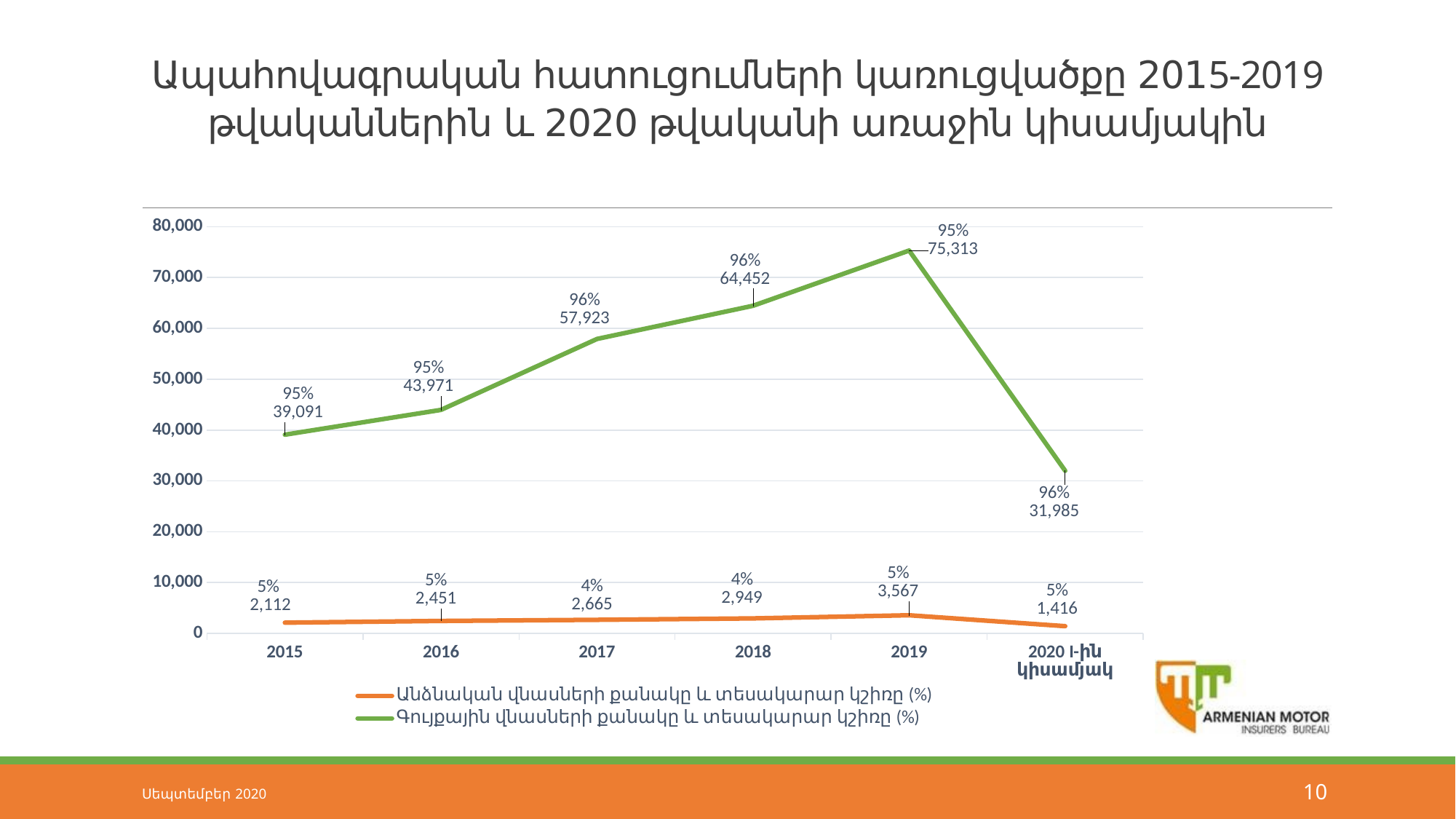
What is the value of the green line for 2017? 57,923 What percentage is labelled on the green line for 2018? 96% In which year does the green line reach its highest value? 2019 Which is larger: the orange line value for 2016 or for 2017? 2017 Does the green line rise or fall from 2015 to 2019? rise What type of chart is shown on the slide? line chart How many points along the x axis does each line have? 6 Which x-axis category has the lowest value on the orange line? 2020 I-ին կիսամյակ What is the value of the orange line for 2019? 3,567 How many series does the legend list? 2 What is the difference between the green line values for 2019 and 2018? 10,861 Is the green line value for 2016 greater or less than 40,000? greater